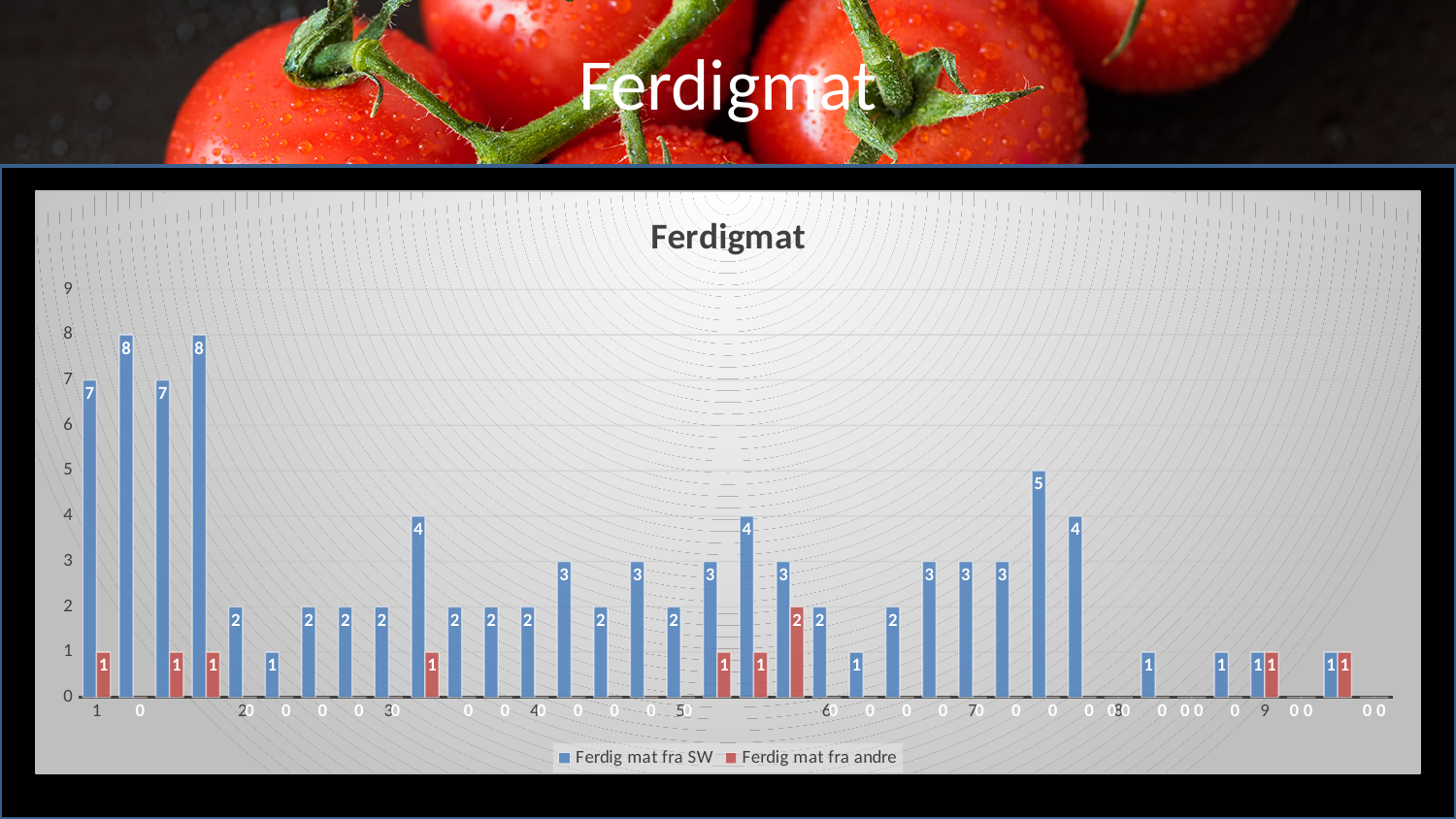
What is the difference between the highest Ferdig mat fra SW value and the highest Ferdig mat fra andre value? 6 At category 1, which series has the larger value, Ferdig mat fra SW or Ferdig mat fra andre? Ferdig mat fra SW What is the value of the Ferdig mat fra andre bar at category 1? 1 What are the two series named in the legend? Ferdig mat fra SW and Ferdig mat fra andre How many series does the legend list? 2 What is the title of the chart? Ferdigmat How many Ferdig mat fra SW bars have a value of 8? 2 What kind of chart is shown on the slide? bar chart What is the highest value shown for the Ferdig mat fra SW series? 8 Is the tallest Ferdig mat fra SW bar greater or less than 5? greater What is the highest value shown for the Ferdig mat fra andre series? 2 What is the value of the Ferdig mat fra SW bar at category 1? 7